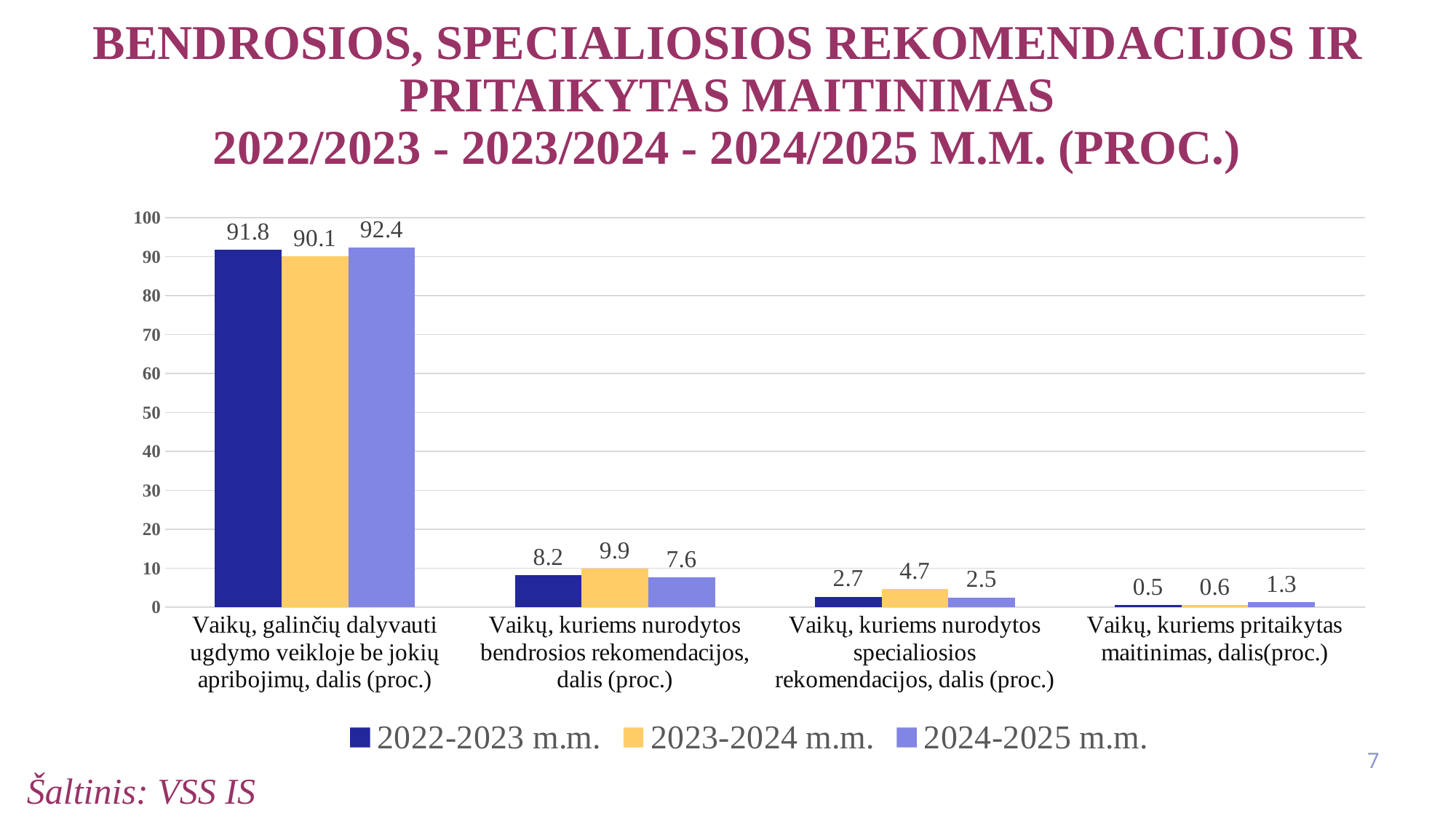
Which category has the lowest values across all three school years? Vaikų, kuriems pritaikytas maitinimas, dalis(proc.) What kind of chart is shown on the slide? bar chart Which school year has the highest value in the category "Vaikų, kuriems nurodytos specialiosios rekomendacijos, dalis (proc.)"? 2023-2024 m.m. Is the 2023-2024 m.m. value for "Vaikų, galinčių dalyvauti ugdymo veikloje be jokių apribojimų, dalis (proc.)" greater or less than 90? greater What is the difference between the 2024-2025 m.m. and 2023-2024 m.m. values in the category "Vaikų, galinčių dalyvauti ugdymo veikloje be jokių apribojimų, dalis (proc.)"? 2.3 What is the value for 2024-2025 m.m. in the category "Vaikų, galinčių dalyvauti ugdymo veikloje be jokių apribojimų, dalis (proc.)"? 92.4 What is the value for 2022-2023 m.m. in the category "Vaikų, kuriems pritaikytas maitinimas, dalis(proc.)"? 0.5 How many categories are shown on the x axis of the chart? 4 Which is larger in the category "Vaikų, kuriems nurodytos bendrosios rekomendacijos, dalis (proc.)": the 2022-2023 m.m. value or the 2024-2025 m.m. value? 2022-2023 m.m. How many series does the legend list? 3 What is the value for 2023-2024 m.m. in the category "Vaikų, kuriems nurodytos bendrosios rekomendacijos, dalis (proc.)"? 9.9 What source is cited at the bottom of the slide? VSS IS